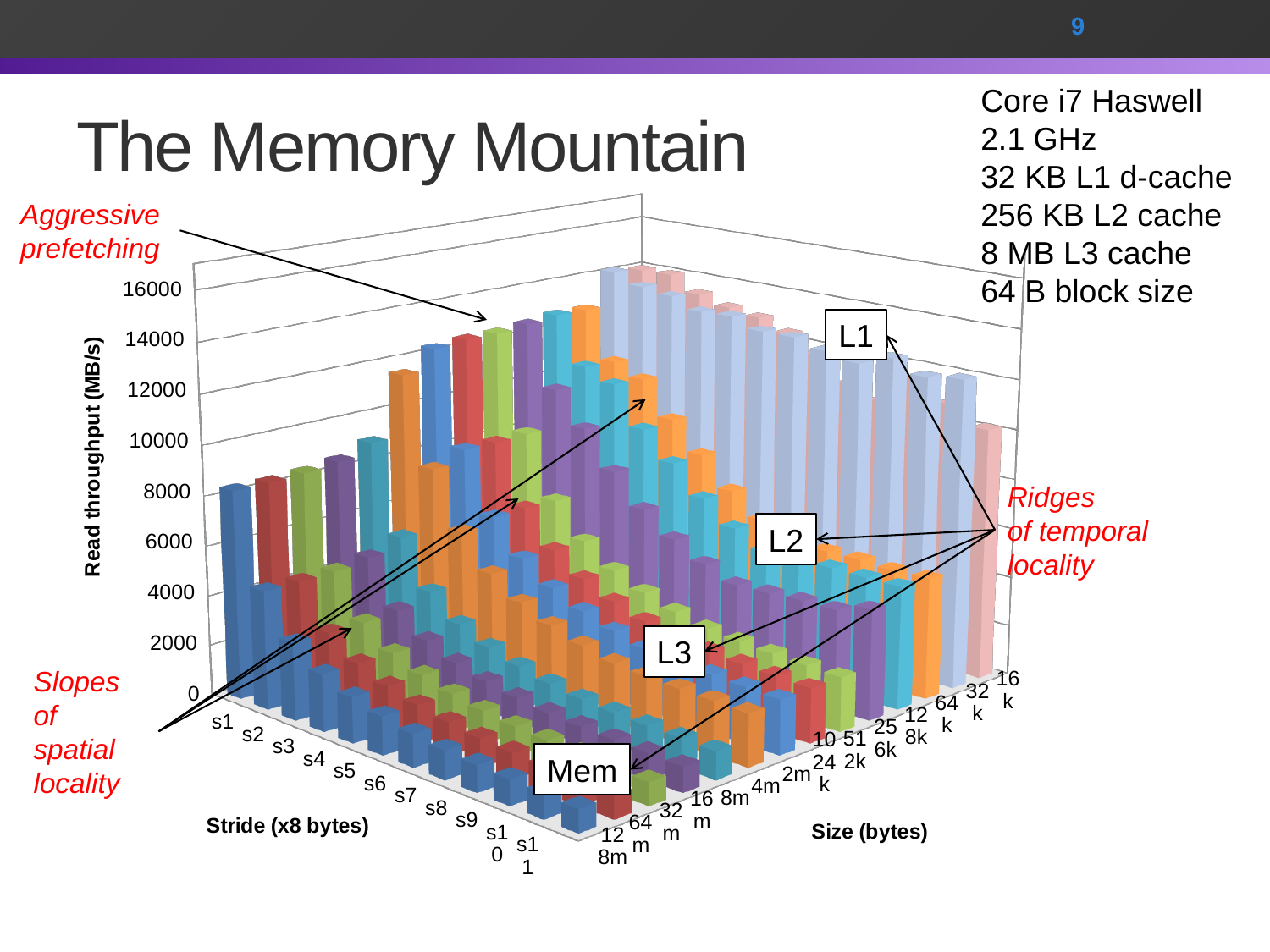
What is the highest tick value shown on the Read throughput axis? 16000 For a fixed large size such as 128m, does read throughput rise or fall as the stride increases from s1 to s11? fall How many size categories are shown on the Size (bytes) axis? 14 What is the label of the vertical axis of the chart? Read throughput (MB/s) What is the title of the chart on the slide? The Memory Mountain Which is larger: the read throughput at stride s1 for size 16k or for size 128m? 16k How many stride categories (s1 through s11) are shown on the stride axis? 11 Which is larger: the read throughput at size 128m for stride s1 or for stride s11? s1 Is the read throughput for stride s1 at size 128m greater or less than 12000? less Is the read throughput for stride s1 at size 16k greater or less than 8000? greater What kind of chart is shown on the slide? 3D bar chart For stride s1, does read throughput rise or fall as the working-set size decreases from 128m toward 16k? rise